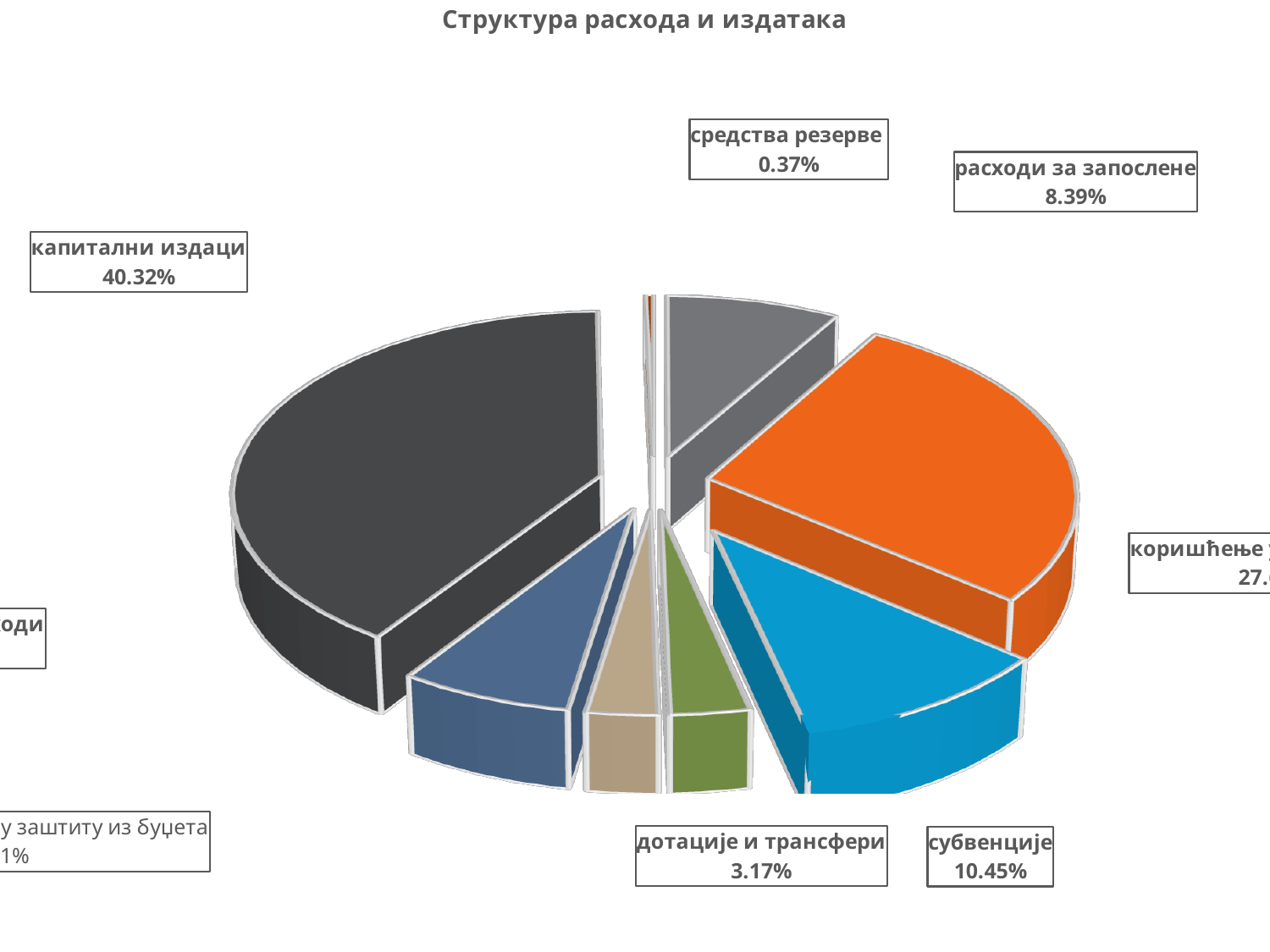
Which is larger, the share for субвенције or the share for расходи за запослене? субвенције What share does капитални издаци have in the pie chart? 40.32% What share does средства резерве have in the pie chart? 0.37% Which category has the largest share of the pie? капитални издаци What share does дотације и трансфери have in the pie chart? 3.17% What is the title of the chart? Структура расхода и издатака What share does субвенције have in the pie chart? 10.45% What kind of chart is shown on the slide? pie chart What is the difference between the shares for капитални издаци and субвенције? 29.87% Which category has the smallest share of the pie? средства резерве What is the difference between the shares for субвенције and дотације и трансфери? 7.28% What share does расходи за запослене have in the pie chart? 8.39%